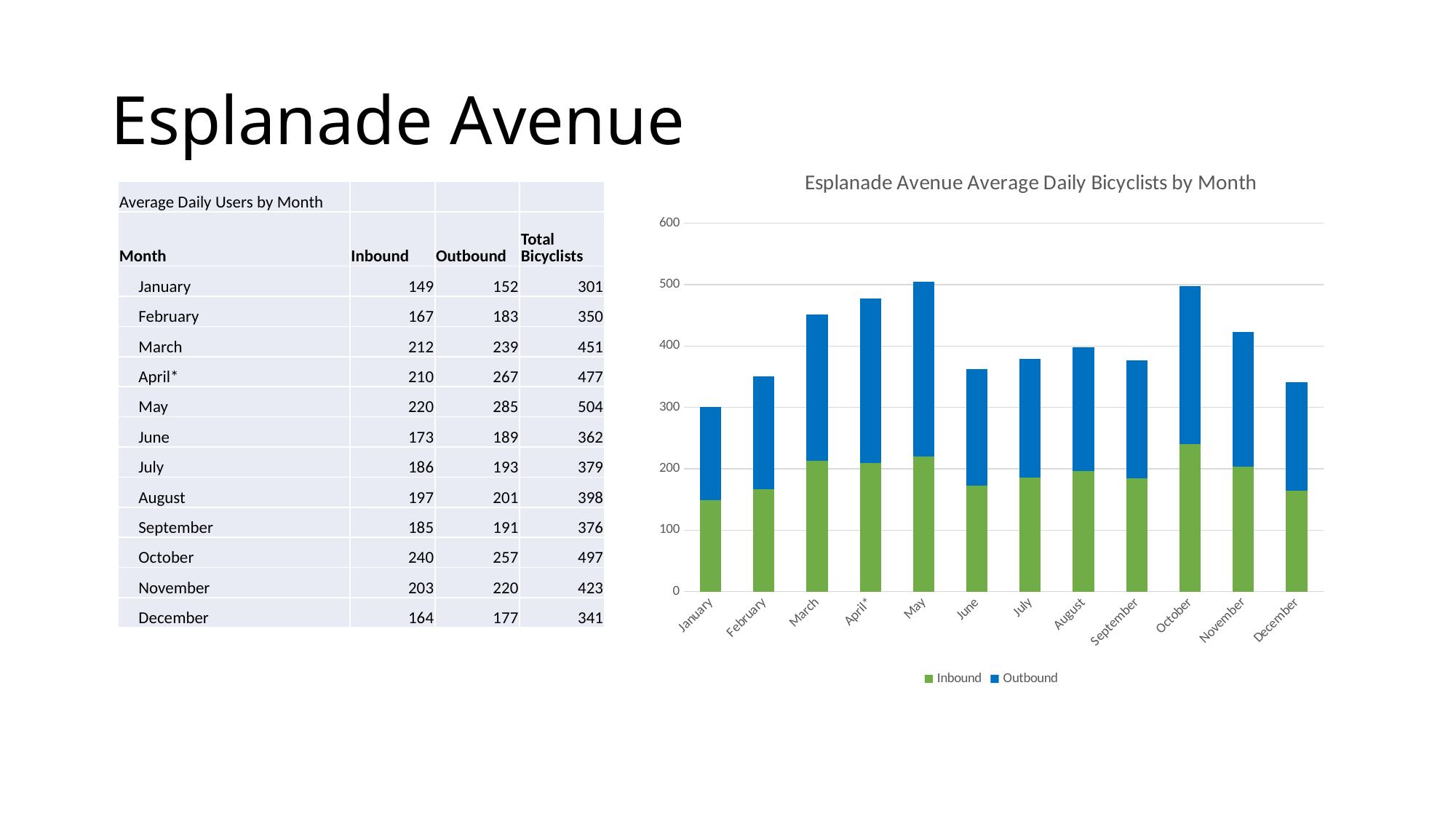
Which month has the highest total bicyclists in the chart? May What is the total of the stacked bar for March? 451 Is the total bicyclists value for June greater or less than 400? less What is the title of the chart? Esplanade Avenue Average Daily Bicyclists by Month What is the Outbound value for May? 285 What is the Inbound value for October? 240 Which is larger, the total bicyclists for October or for November? October How many series does the chart legend list? 2 How many months are plotted on the x axis of the chart? 12 What is the difference between the Outbound and Inbound values for April*? 57 What type of chart is shown on the slide? Stacked bar chart Which month has the lowest total bicyclists in the chart? January